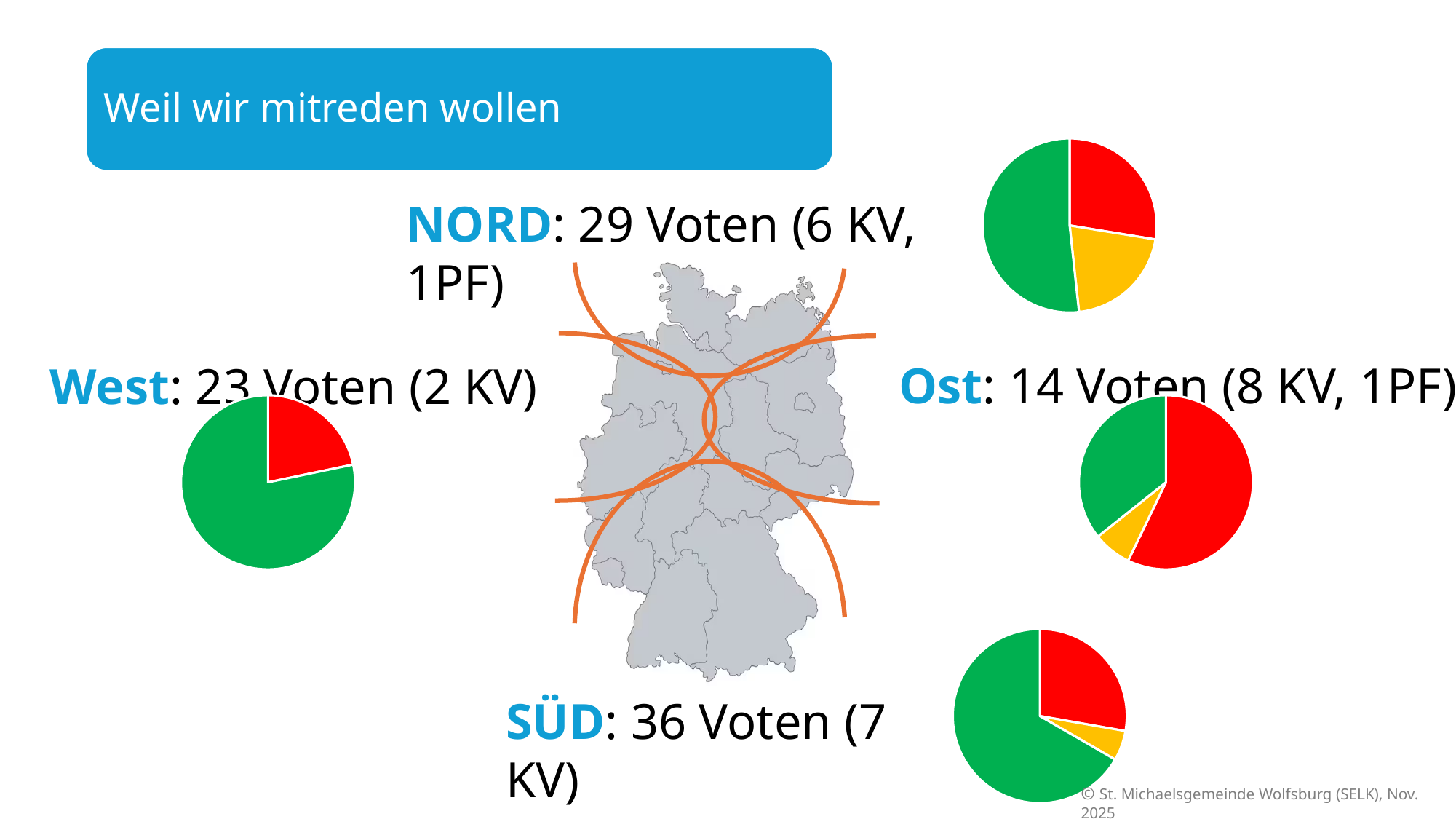
In the pie chart next to the SÜD label, which colour is the smallest slice? yellow What is the difference in Voten between the SÜD region and the Ost region? 22 What kind of chart is shown next to the NORD label? pie chart In the pie chart next to the Ost label, which colour is the largest slice? red In the pie chart next to the West label, which colour is the largest slice? green In the pie chart next to the NORD label, is the red slice or the yellow slice larger? red How many slices does the pie chart next to the West label have? 2 How many slices does the pie chart next to the NORD label have? 3 Which region has the most Voten according to the slide? SÜD In the pie chart next to the Ost label, is the green slice or the yellow slice larger? green How many pie charts are on the slide? 4 How many Voten are stated for the SÜD region? 36 Voten